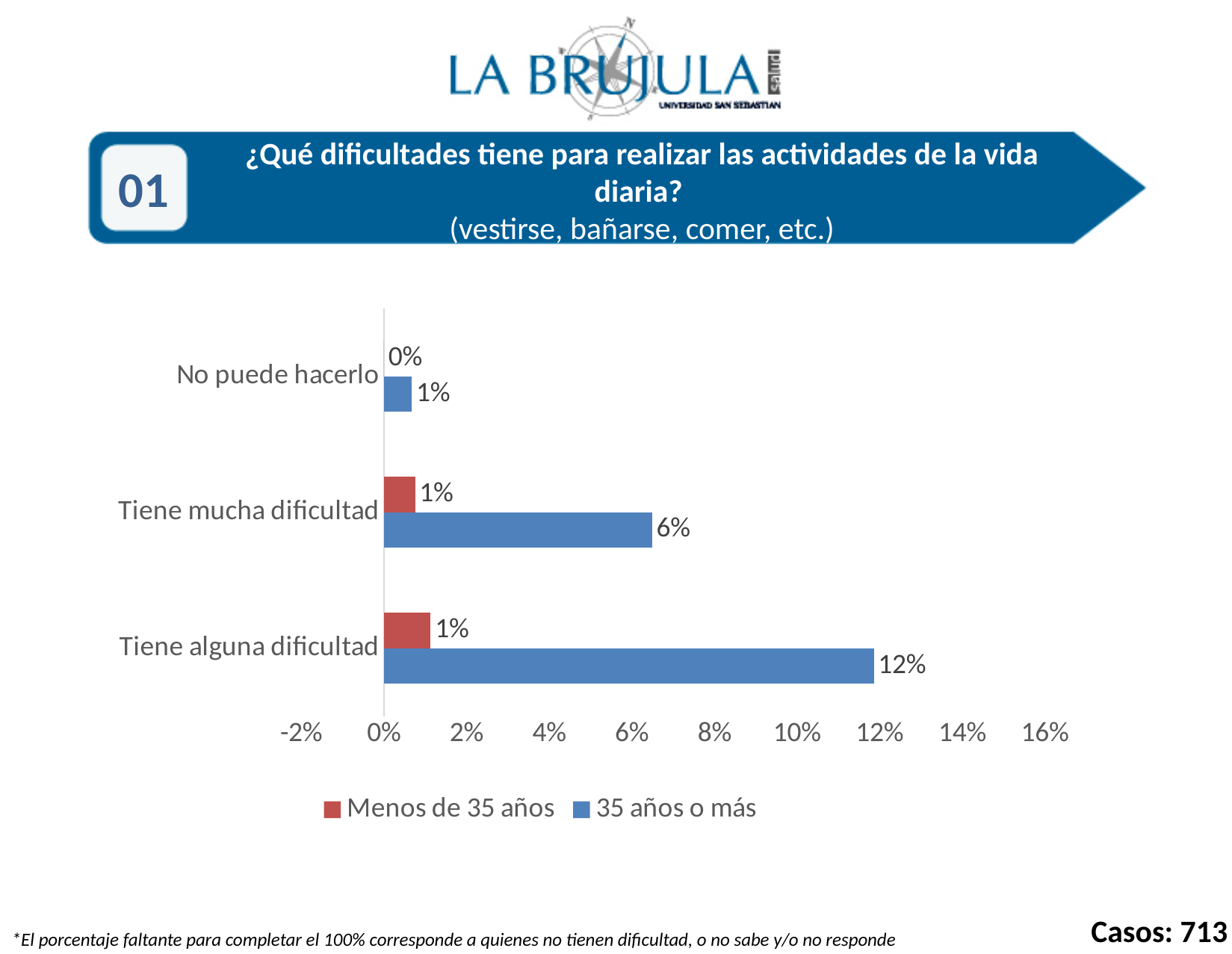
How many series does the legend list? 2 How many categories are shown on the chart? 3 What is the value for "35 años o más" in the "No puede hacerlo" category? 1% What is the difference between the "35 años o más" values for "Tiene alguna dificultad" and "Tiene mucha dificultad"? 6% Which category has the lowest value for "35 años o más"? No puede hacerlo What kind of chart is shown on the slide? Bar chart Which category has the highest value for "35 años o más"? Tiene alguna dificultad Which is larger in the "Tiene mucha dificultad" category: "Menos de 35 años" or "35 años o más"? 35 años o más What is the value for "35 años o más" in the "Tiene alguna dificultad" category? 12% What is the value for "35 años o más" in the "Tiene mucha dificultad" category? 6% What is the value for "Menos de 35 años" in the "No puede hacerlo" category? 0% Is the value for "35 años o más" in "Tiene alguna dificultad" greater or less than 10%? greater